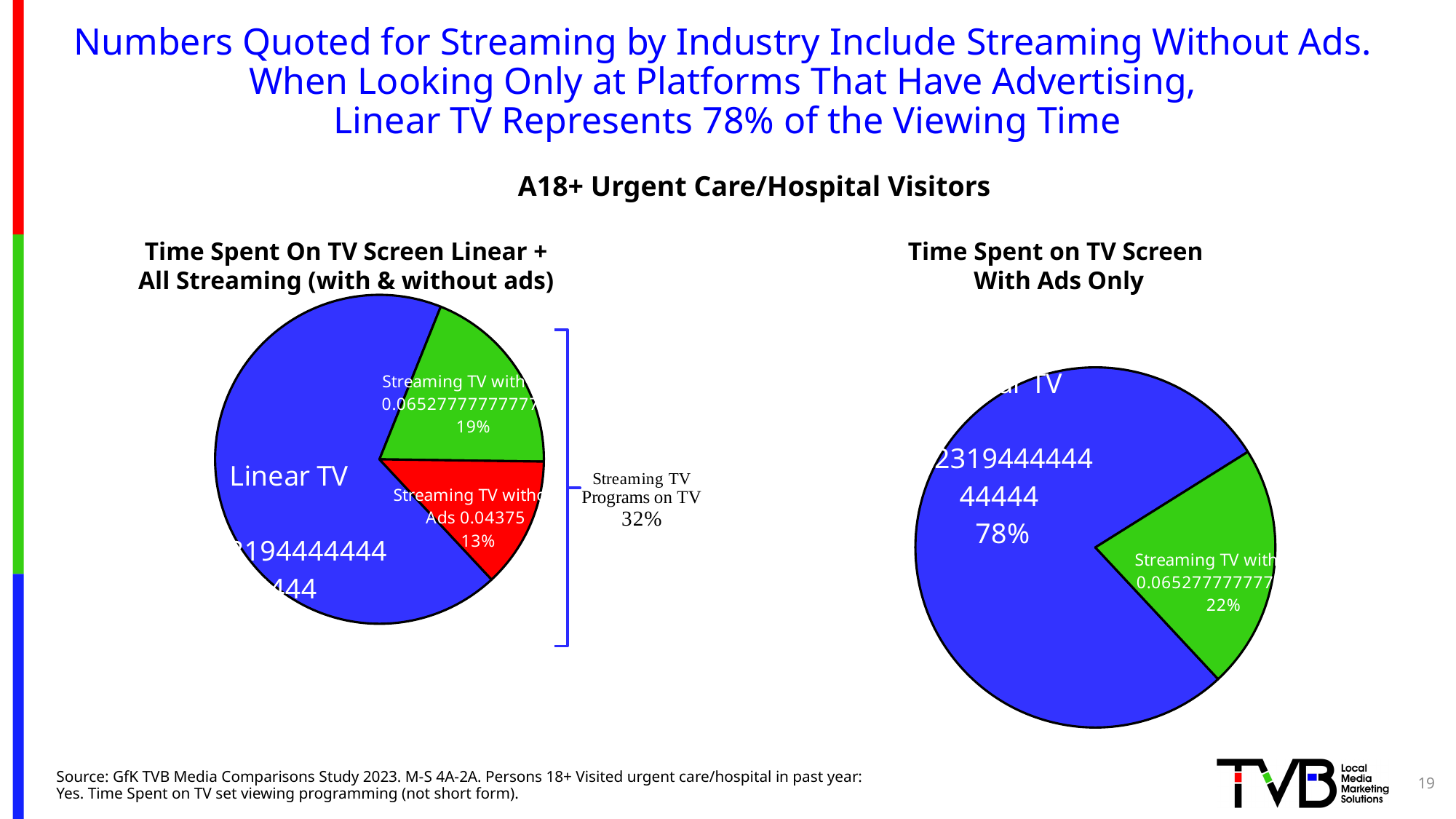
In the right pie chart, how many percentage points larger is Linear TV than Streaming TV with Ads? 56 percentage points In the 'Time Spent on TV Screen With Ads Only' pie chart, what share does Streaming TV with Ads represent? 22% In the left pie chart, what colour is the Linear TV slice? Blue In the 'Time Spent On TV Screen Linear + All Streaming (with & without ads)' pie chart, what share does Streaming TV with Ads represent? 19% In the left pie chart, how many percentage points larger is Streaming TV with Ads than Streaming TV without Ads? 6 percentage points What type of chart is used on this slide? Pie chart In the 'Time Spent On TV Screen Linear + All Streaming (with & without ads)' pie chart, what share does Streaming TV without Ads represent? 13% How many slices does the 'Time Spent on TV Screen With Ads Only' pie chart have? 2 In the left pie chart, what combined share is shown for Streaming TV Programs on TV? 32% In the left pie chart, which slice is the smallest? Streaming TV without Ads In the left pie chart, which slice is the largest? Linear TV